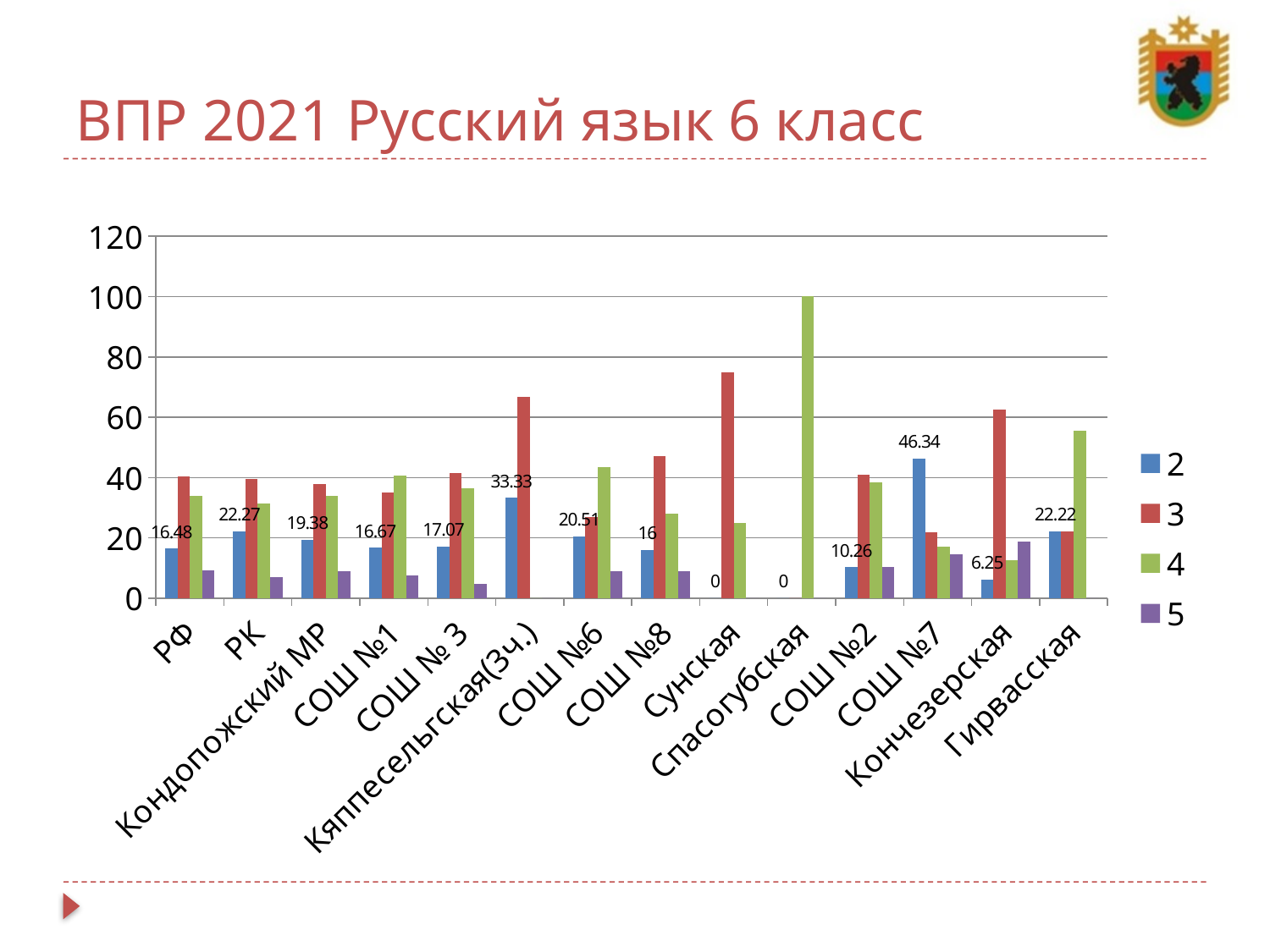
What is the value of series 2 for Кяппесельгская(Зч.)? 33.33 Is the value of series 4 for Спасогубская greater or less than 80? greater Which category has the highest value for series 2? СОШ №7 What kind of chart is shown on the slide? bar chart Which has the larger series 2 value, РК or РФ? РК What is the title of the chart? ВПР 2021 Русский язык 6 класс What is the value of series 2 for Кончезерская? 6.25 How many series does the legend list? 4 What is the value of series 2 for РФ? 16.48 What is the value of series 2 for СОШ №7? 46.34 How many categories are shown along the x axis? 14 What is the difference between the series 2 values for СОШ №7 and Кяппесельгская(Зч.)? 13.01